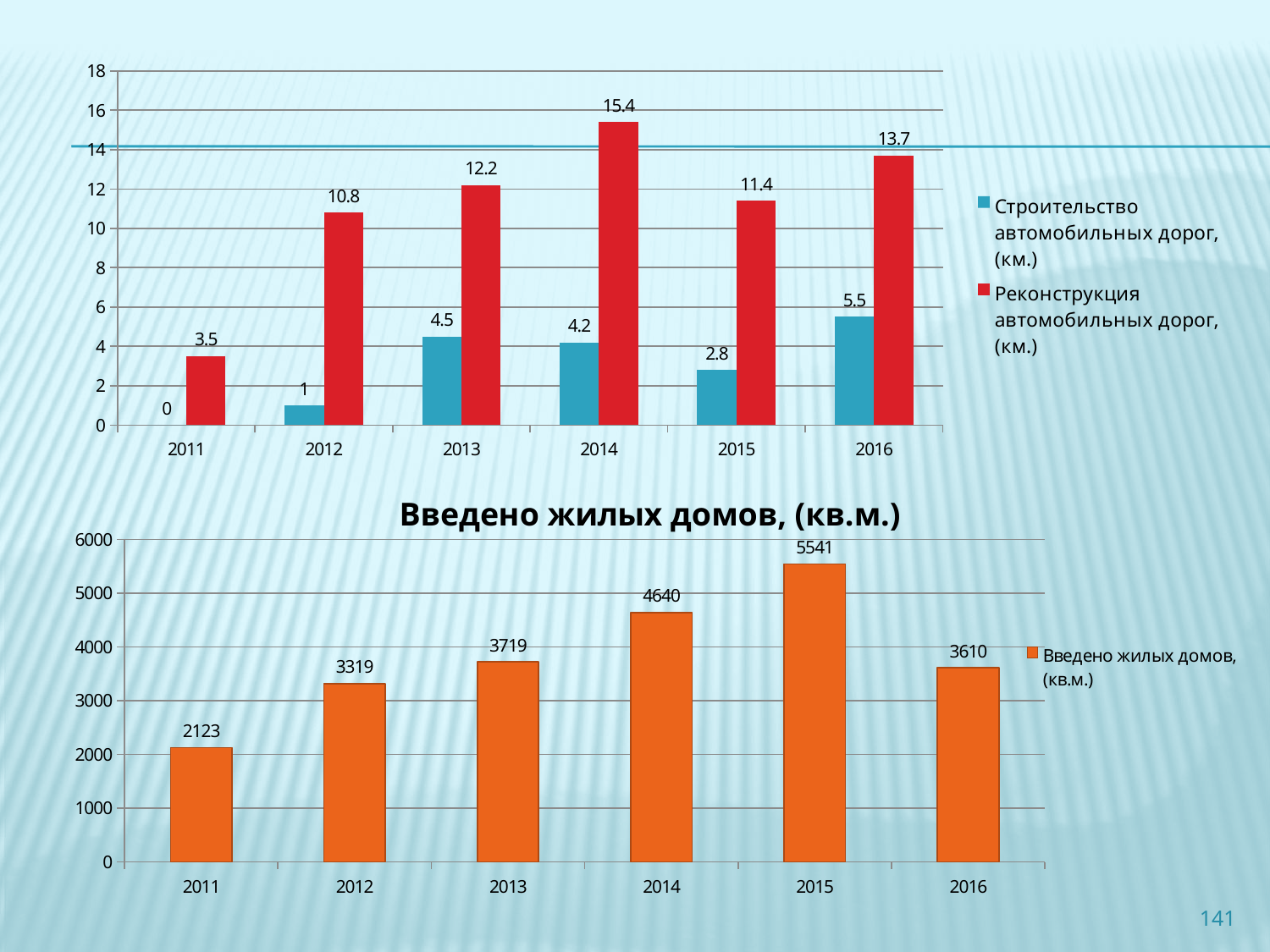
In the top chart, what is the difference between Реконструкция and Строительство автомобильных дорог in 2013? 7.7 In the chart titled 'Введено жилых домов, (кв.м.)', which year has the lowest value? 2011 What type of chart is the bottom chart? Bar chart In the chart titled 'Введено жилых домов, (кв.м.)', how many years are shown on the x axis? 6 In the top chart, how many series does the legend list? 2 In the top chart, which year has the lowest value for Строительство автомобильных дорог? 2011 In the top chart, what is the value for Строительство автомобильных дорог in 2016? 5.5 In the chart titled 'Введено жилых домов, (кв.м.)', what is the difference between 2014 and 2013? 921 In the top chart, which is larger in 2015: Строительство or Реконструкция автомобильных дорог? Реконструкция автомобильных дорог In the top chart, what is the value for Реконструкция автомобильных дорог in 2014? 15.4 In the top chart, which year has the highest value for Реконструкция автомобильных дорог? 2014 In the chart titled 'Введено жилых домов, (кв.м.)', what is the value for 2015? 5541